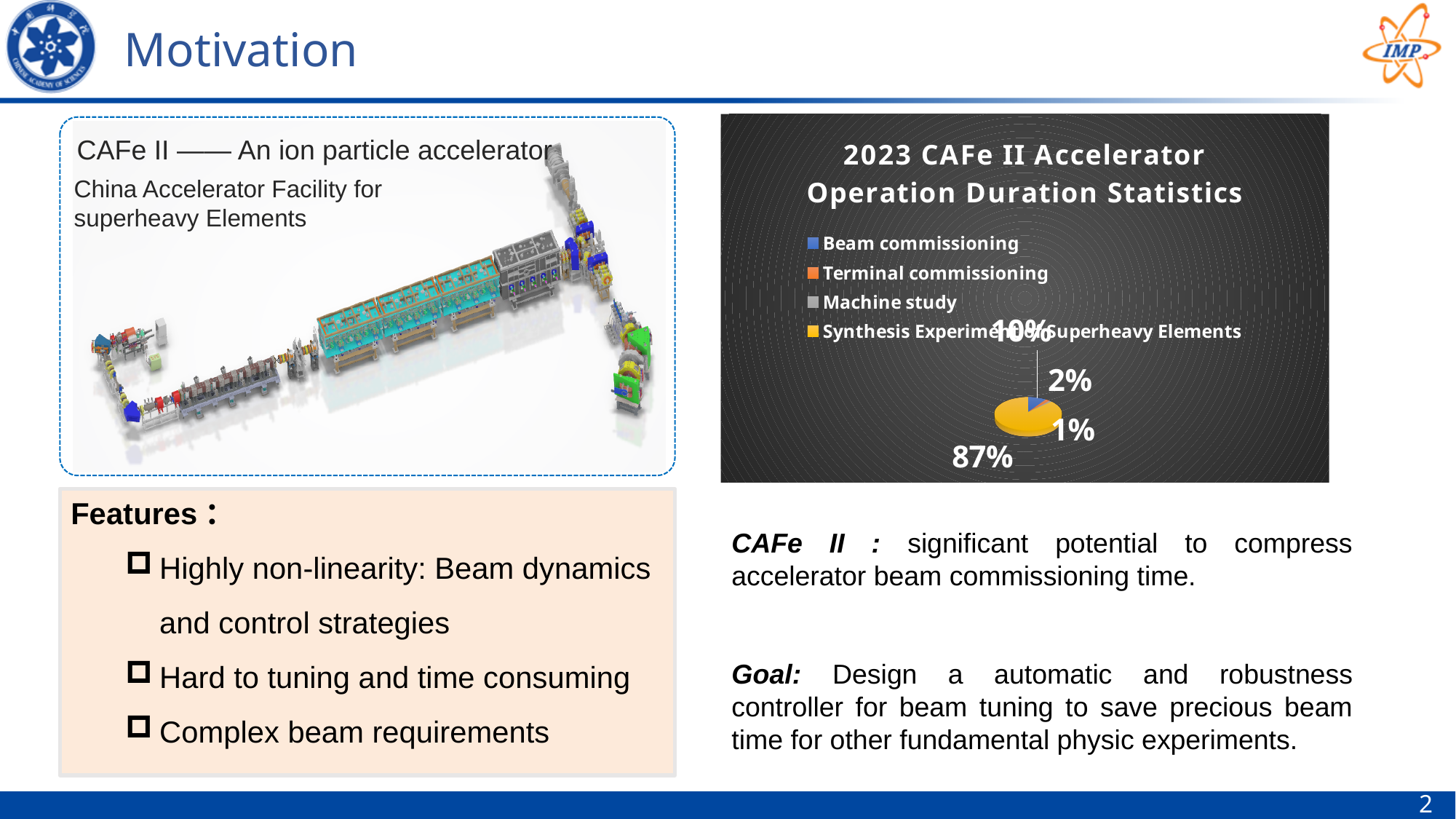
What share of the pie is Terminal commissioning? 2% Which category has the largest slice of the pie? Synthesis Experiment of Superheavy Elements How many entries does the chart's legend list? 4 What share of the pie is Beam commissioning? 10% Which category has the smallest slice of the pie? Machine study Which is larger, the Beam commissioning slice or the Terminal commissioning slice? Beam commissioning How many slices does the pie chart have? 4 What share of the pie is Synthesis Experiment of Superheavy Elements? 87% What kind of chart is shown on the slide? pie chart What colour is the largest slice of the pie? yellow What is the title of the chart? 2023 CAFe II Accelerator Operation Duration Statistics What is the difference in percentage points between the Synthesis Experiment of Superheavy Elements slice and the Beam commissioning slice? 77